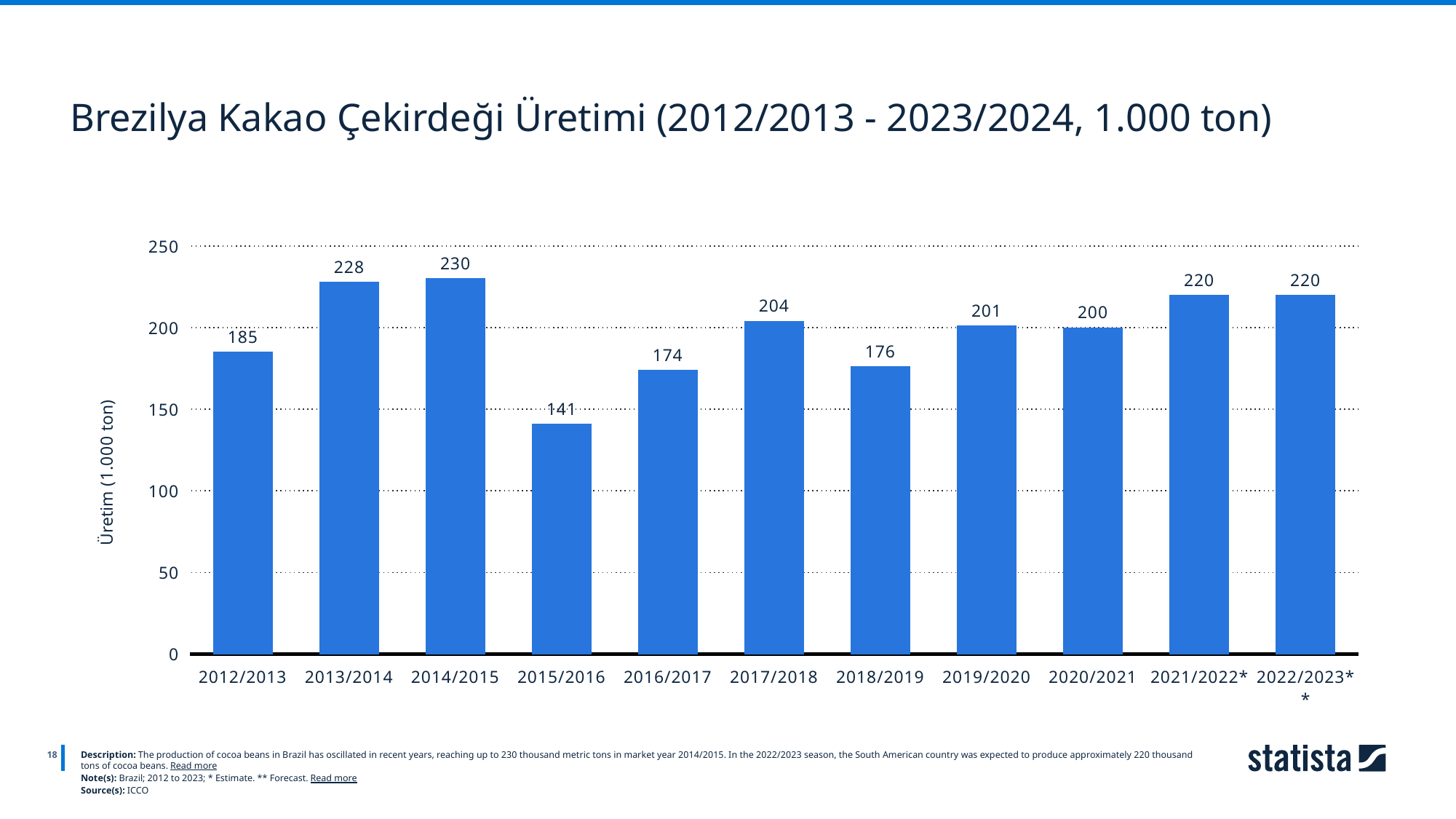
What is the cocoa bean production value for 2018/2019? 176 What is the y-axis label of the chart? Üretim (1.000 ton) What is the cocoa bean production value for 2015/2016? 141 Is the value for 2019/2020 greater or less than 150? greater How many seasons are shown on the x axis? 11 Which season has the lowest cocoa bean production? 2015/2016 What is the cocoa bean production value for 2014/2015? 230 What is the difference between the production in 2013/2014 and 2012/2013? 43 Which is larger, the production in 2017/2018 or in 2016/2017? 2017/2018 Which season has the highest cocoa bean production? 2014/2015 What is the difference between the production in 2014/2015 and 2015/2016? 89 What kind of chart is shown on the slide? bar chart